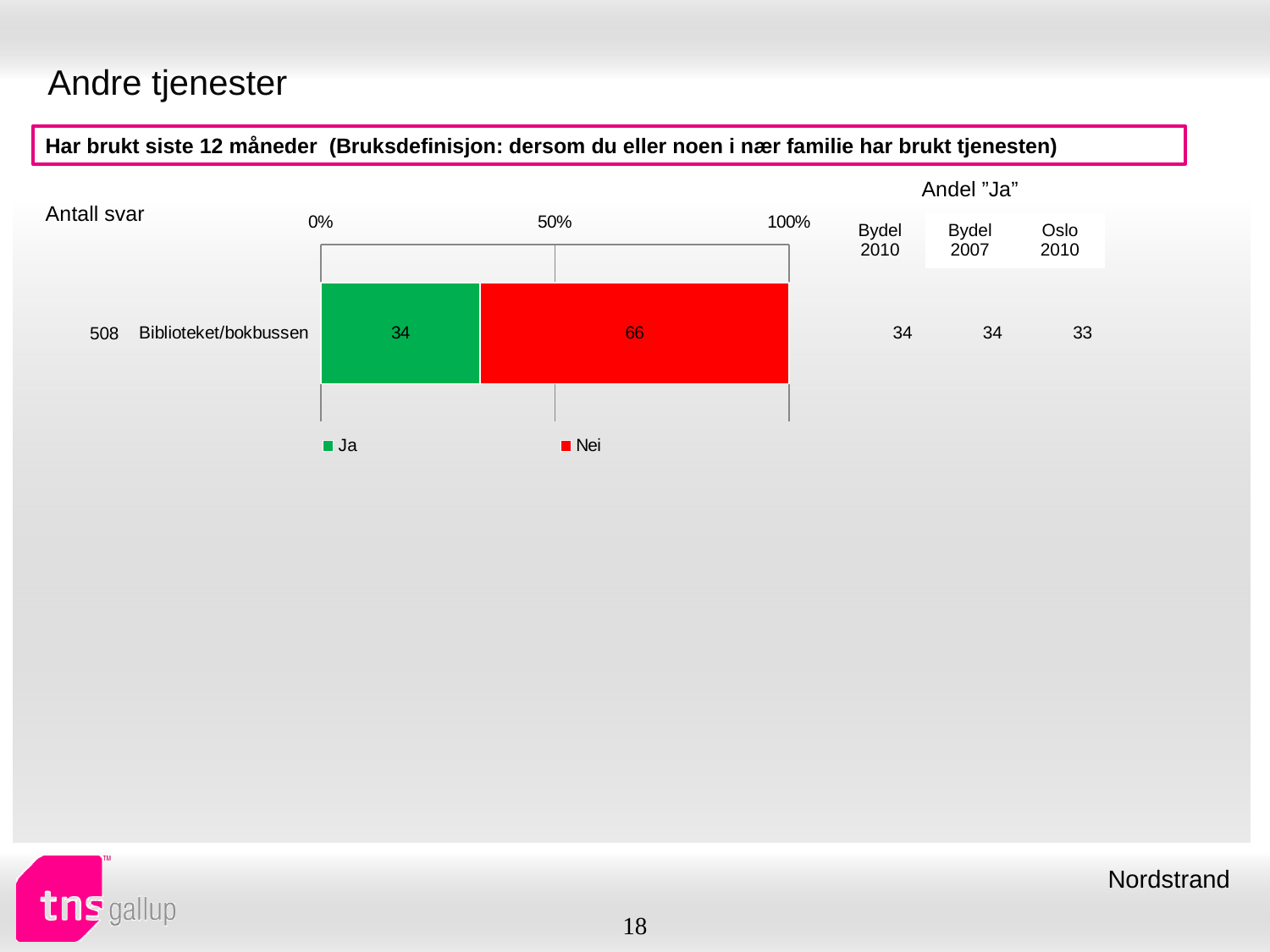
What is the difference between the Nei and Ja values for Biblioteket/bokbussen? 32 What is the Andel "Ja" value for Oslo 2010 for Biblioteket/bokbussen? 33 What is the total of the stacked bar for Biblioteket/bokbussen? 100 How many categories are plotted in the chart? 1 Is the value for Nei for Biblioteket/bokbussen greater or less than 50%? greater Which series has the larger value for Biblioteket/bokbussen, Ja or Nei? Nei What is the number of responses (Antall svar) for Biblioteket/bokbussen? 508 What colour represents the "Ja" series in the chart? Green What is the value for "Ja" for Biblioteket/bokbussen? 34 What kind of chart is shown on the slide? Stacked bar chart How many series does the legend list? 2 What is the value for "Nei" for Biblioteket/bokbussen? 66